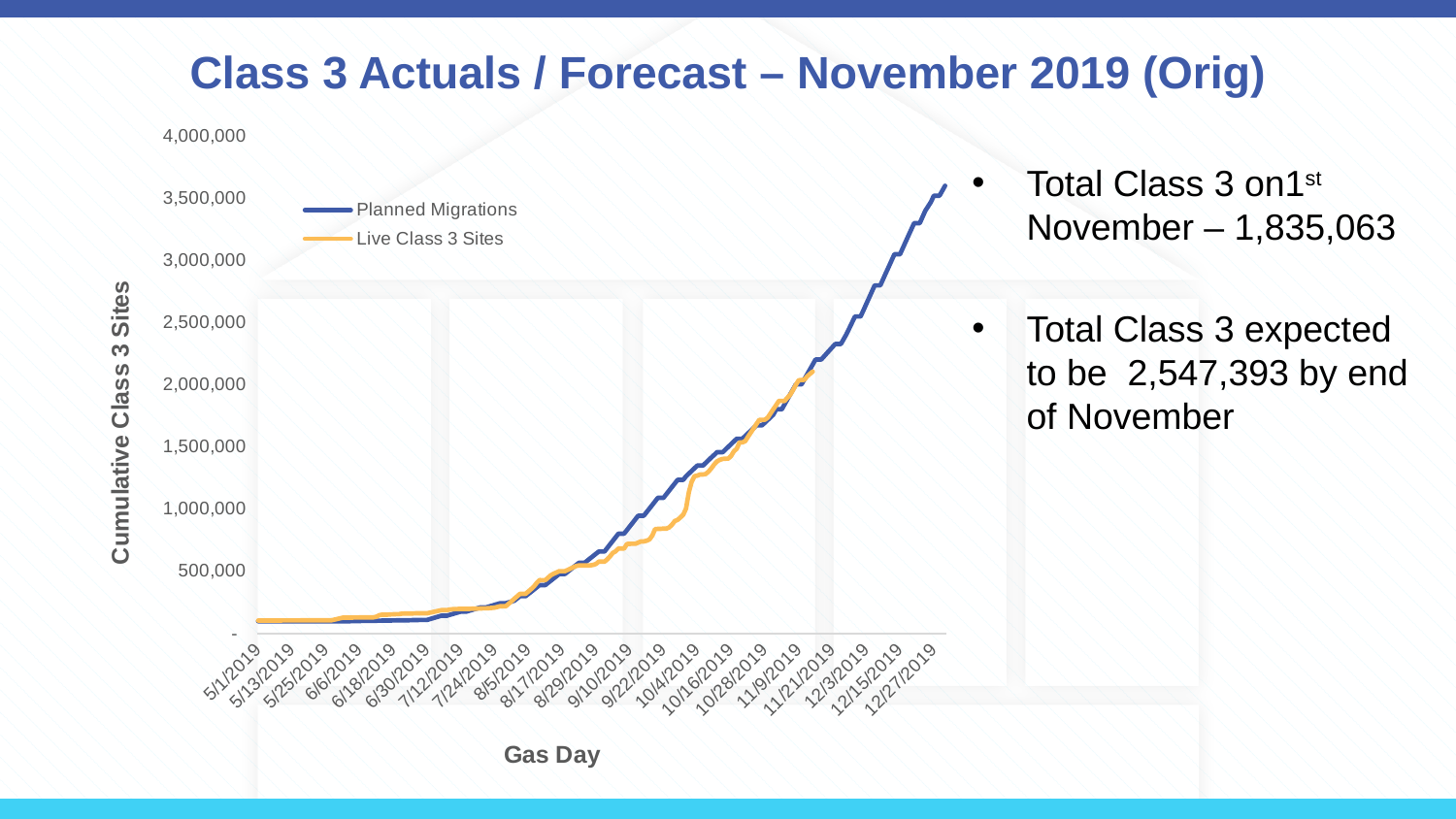
What kind of chart is shown on the slide? Line chart Do the values of the Planned Migrations line rise or fall along the x axis? Rise What is the highest value labelled on the chart's vertical axis? 4,000,000 What is the title of the chart's vertical axis? Cumulative Class 3 Sites Which series reaches the highest value on the chart? Planned Migrations Is the value of Live Class 3 Sites at 9/22/2019 greater or less than 1,000,000? less Is the value of Planned Migrations at 8/5/2019 greater or less than 500,000? less What are the two series named in the chart's legend? Planned Migrations and Live Class 3 Sites Is the value of Planned Migrations at 10/4/2019 greater or less than 1,000,000? greater At 10/4/2019, which series has the higher value, Planned Migrations or Live Class 3 Sites? Planned Migrations How many series does the chart's legend list? 2